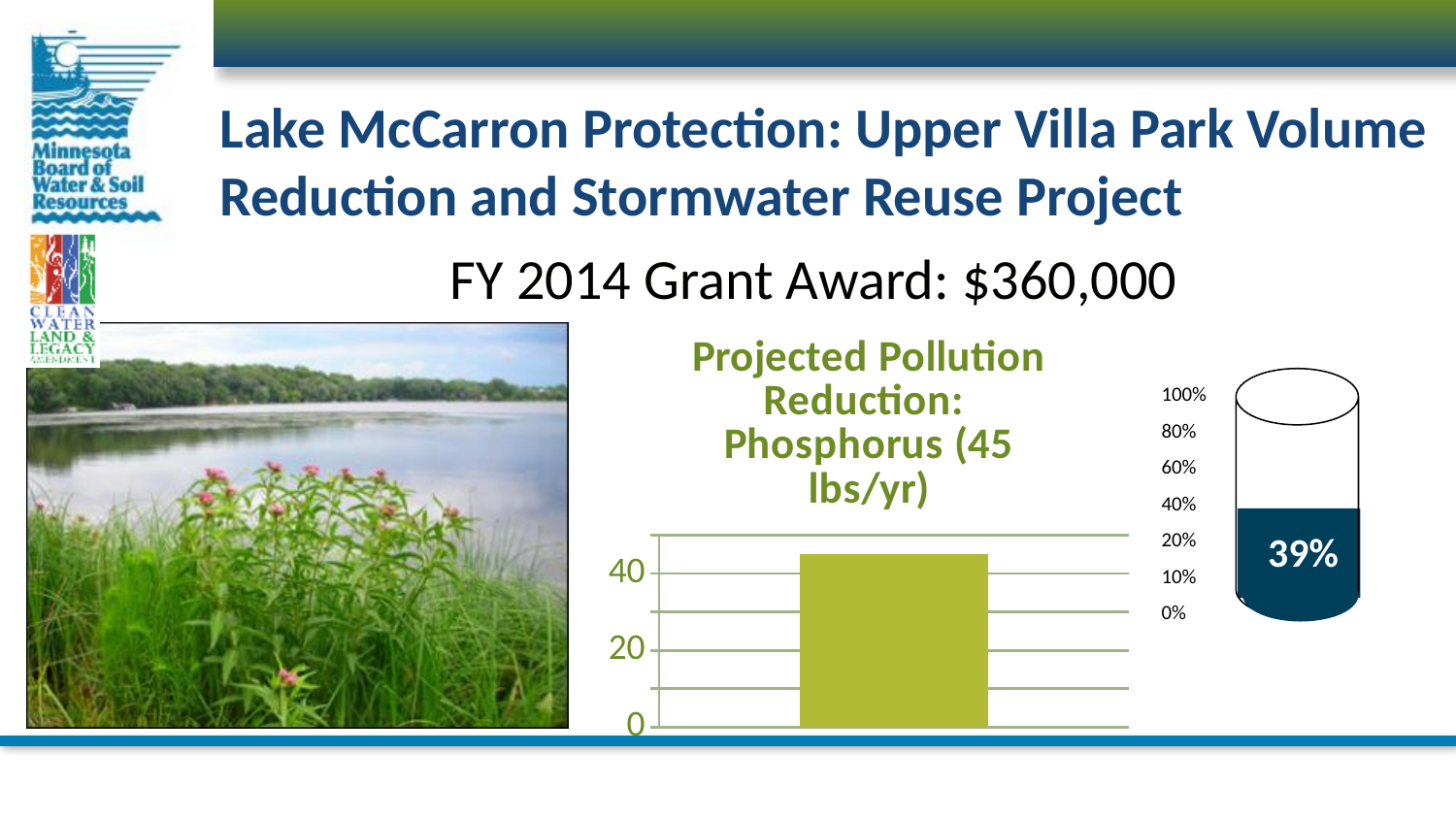
What is the highest tick label shown on the y-axis of the 'Projected Pollution Reduction' bar chart? 40 How many bars are plotted in the 'Projected Pollution Reduction' bar chart? 1 What is the title of the bar chart on the slide? Projected Pollution Reduction: Phosphorus (45 lbs/yr) In the 'Projected Pollution Reduction' bar chart, is the bar's value greater or less than 40? greater According to the chart title, what is the projected phosphorus reduction? 45 lbs/yr On the cylinder gauge, is the filled value greater or less than 50%? less On the cylinder gauge, is the filled value greater or less than 20%? greater What percentage is shown on the cylinder gauge to the right of the bar chart? 39% What kind of chart is the 'Projected Pollution Reduction' chart? bar chart